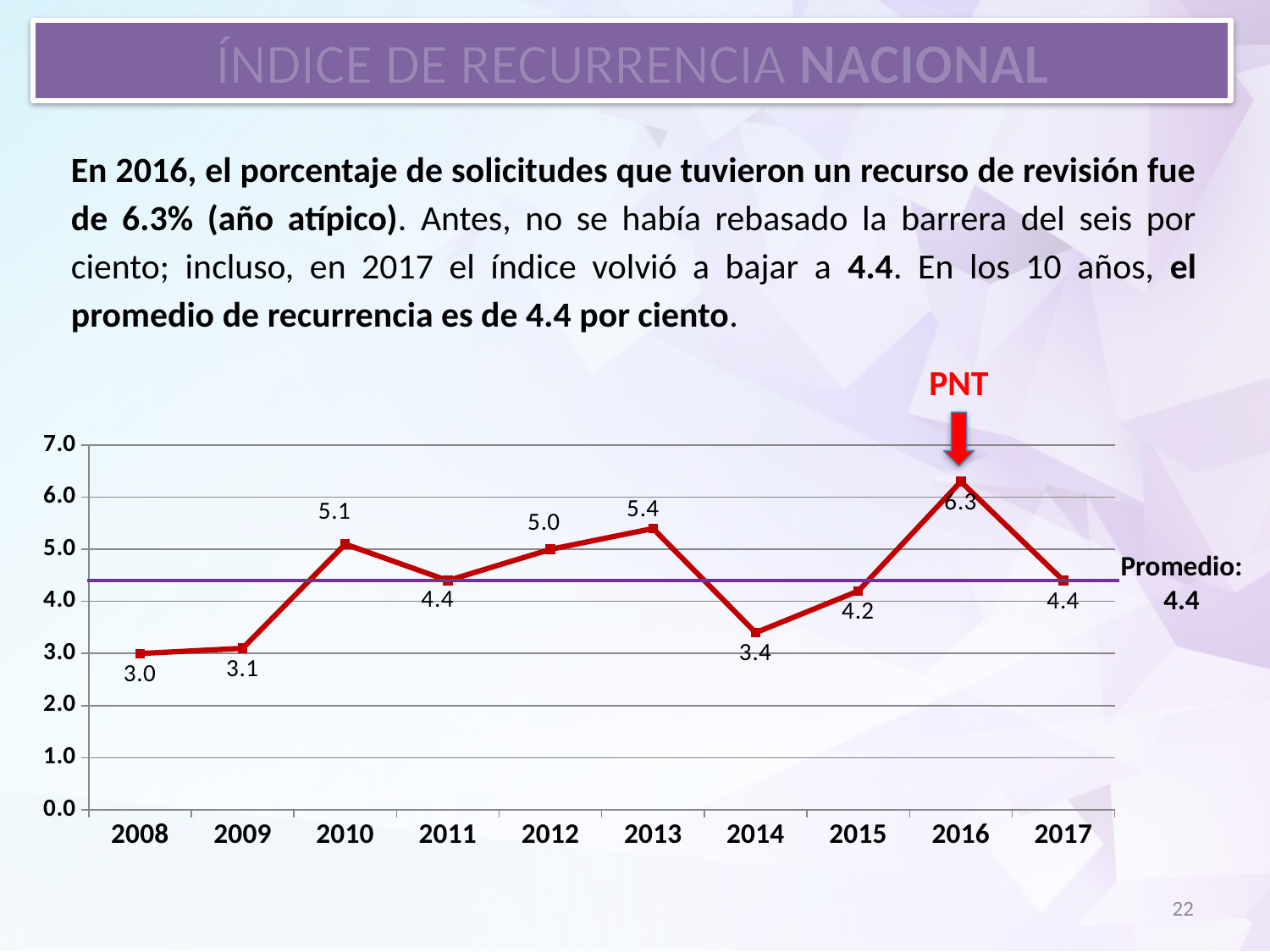
What kind of chart is shown? line chart What value does the horizontal 'Promedio' line mark? 4.4 Is the value for 2014 greater or less than 4.0? less Does the value rise or fall from 2013 to 2014? fall Which year has the highest value? 2016 Which is larger, the value for 2010 or the value for 2012? 2010 What is the value for 2013? 5.4 Which year has the lowest value? 2008 What is the value for 2008? 3.0 How many years are plotted on the x axis? 10 What is the difference between the values for 2016 and 2017? 1.9 What is the value for 2016? 6.3